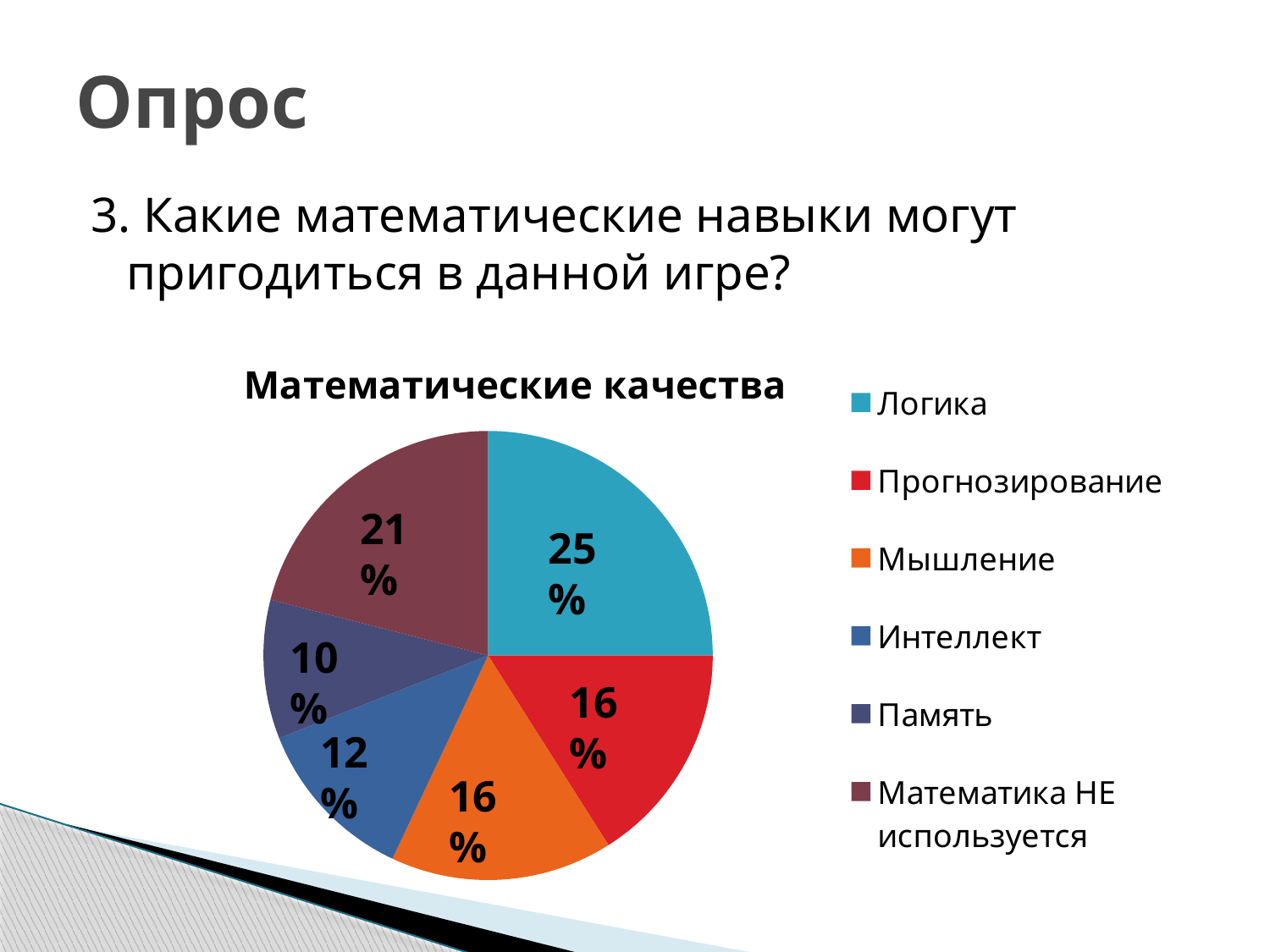
Which category has the smallest share of the pie? Память How many slices does the pie chart have? 6 What share of the pie does Математика НЕ используется have? 21% What share of the pie does Интеллект have? 12% Which is larger, the share for Математика НЕ используется or the share for Мышление? Математика НЕ используется Which category has the largest share of the pie? Логика What type of chart is shown on the slide? pie chart What share of the pie does Логика have? 25% What is the title of the chart? Математические качества What is the difference between the shares of Логика and Память? 15% What share of the pie does Память have? 10% Which legend entry is shown in red? Прогнозирование